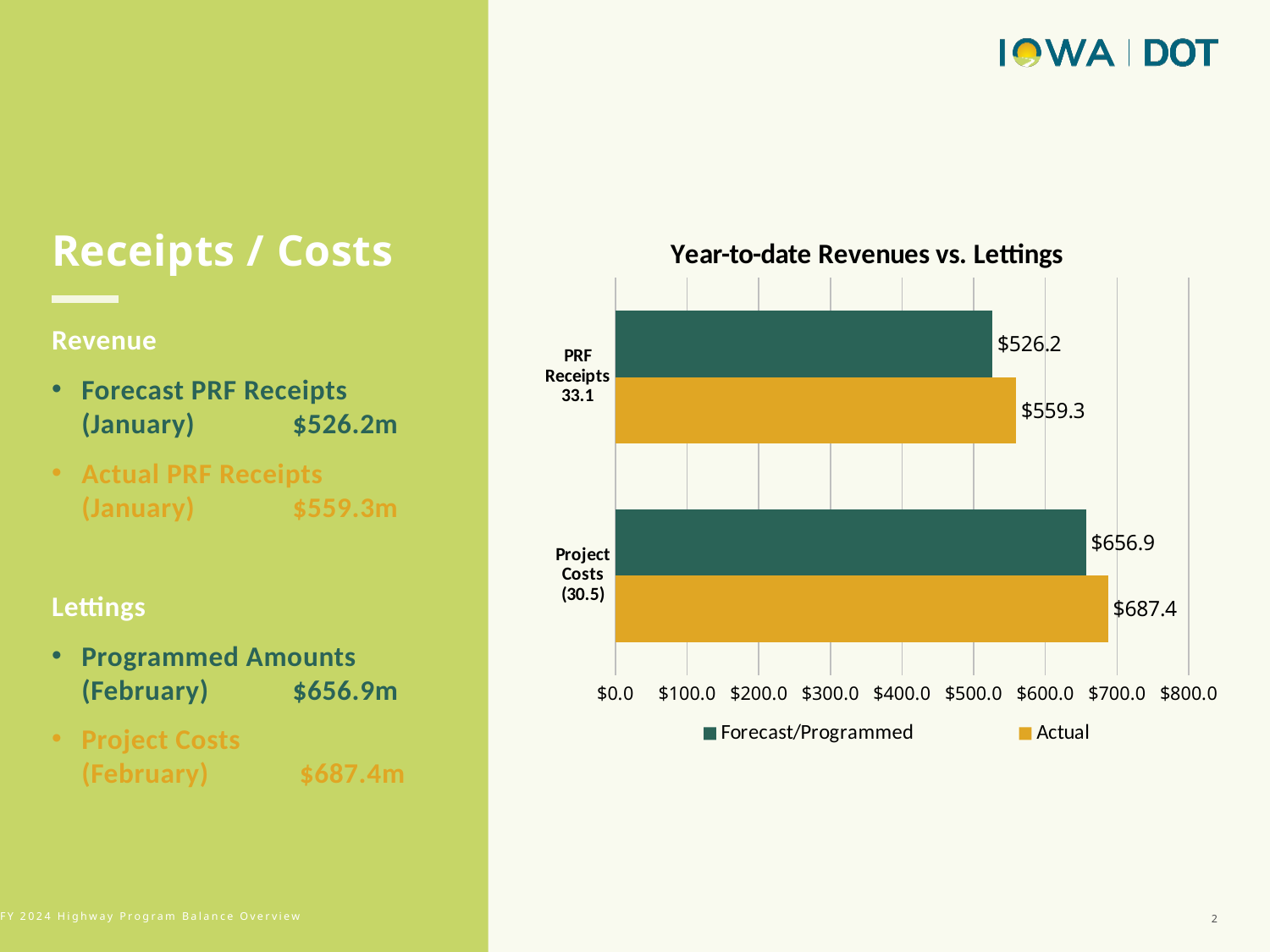
What is the Actual value for Project Costs? $687.4 How many categories are shown on the chart? 2 Which bar has the highest value on the chart? Actual Project Costs ($687.4) What is the difference between the Actual and Forecast/Programmed values for PRF Receipts? $33.1 Which is larger for Project Costs, the Forecast/Programmed value or the Actual value? Actual What is the Actual value for PRF Receipts? $559.3 How many series does the legend list? 2 What is the difference between the Actual and Forecast/Programmed values for Project Costs? $30.5 What is the Forecast/Programmed value for PRF Receipts? $526.2 What is the title of the chart? Year-to-date Revenues vs. Lettings What is the Forecast/Programmed value for Project Costs? $656.9 What type of chart is shown on the slide? bar chart